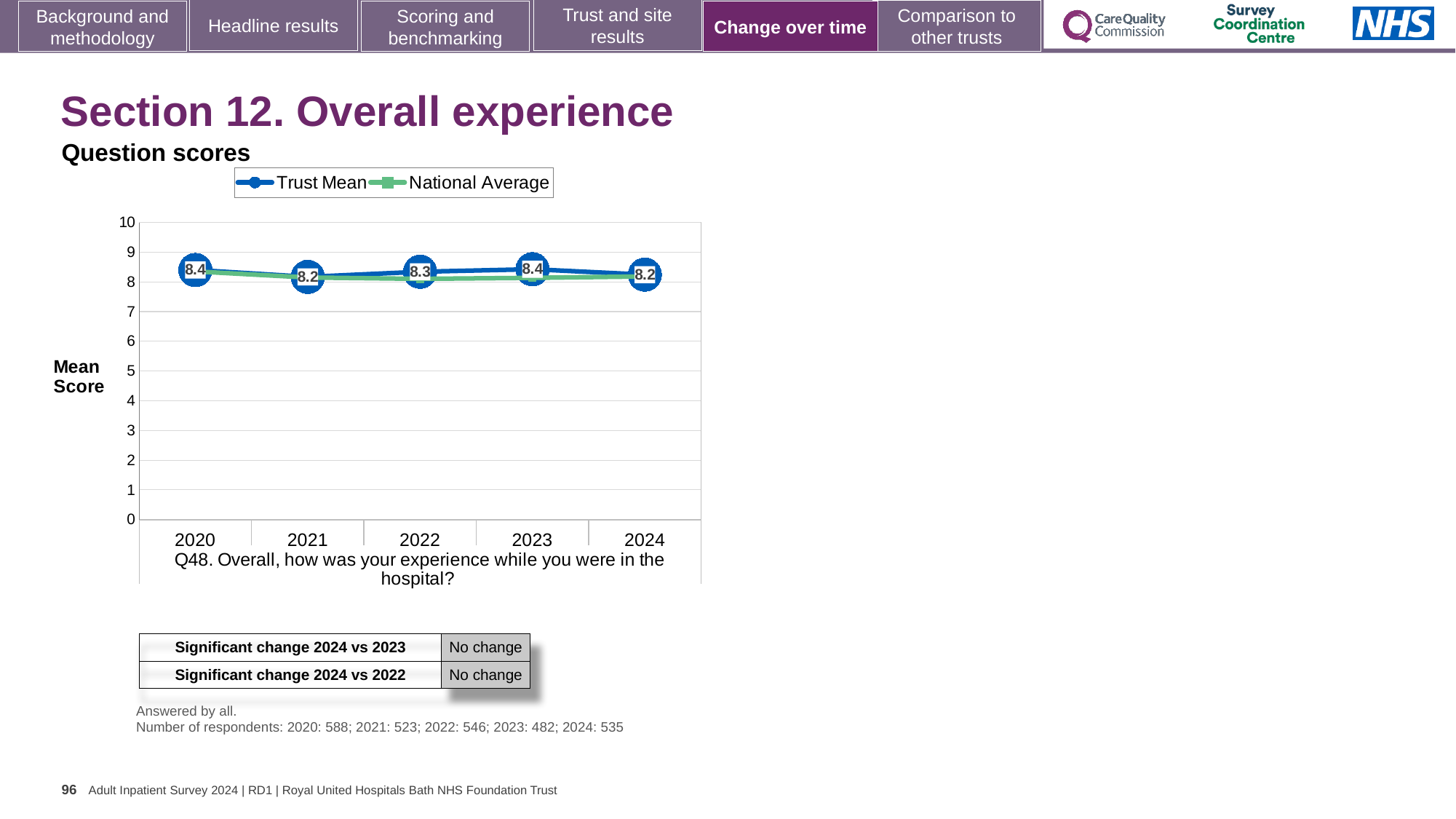
How many series does the chart legend list? 2 Is the National Average value for 2022 greater or less than 7? greater Did the Trust Mean score rise or fall from 2023 to 2024? fall What is the Trust Mean score for 2024? 8.2 What kind of chart is shown on the slide? line chart What is the Trust Mean score for 2021? 8.2 Which year has the lowest Trust Mean score, 2021 or 2023? 2021 What is the Trust Mean score for 2022? 8.3 What is the difference between the Trust Mean score in 2023 and in 2024? 0.2 What is the Trust Mean score for 2020? 8.4 How many years are shown on the x axis of the chart? 5 What is the label of the y axis of the chart? Mean Score